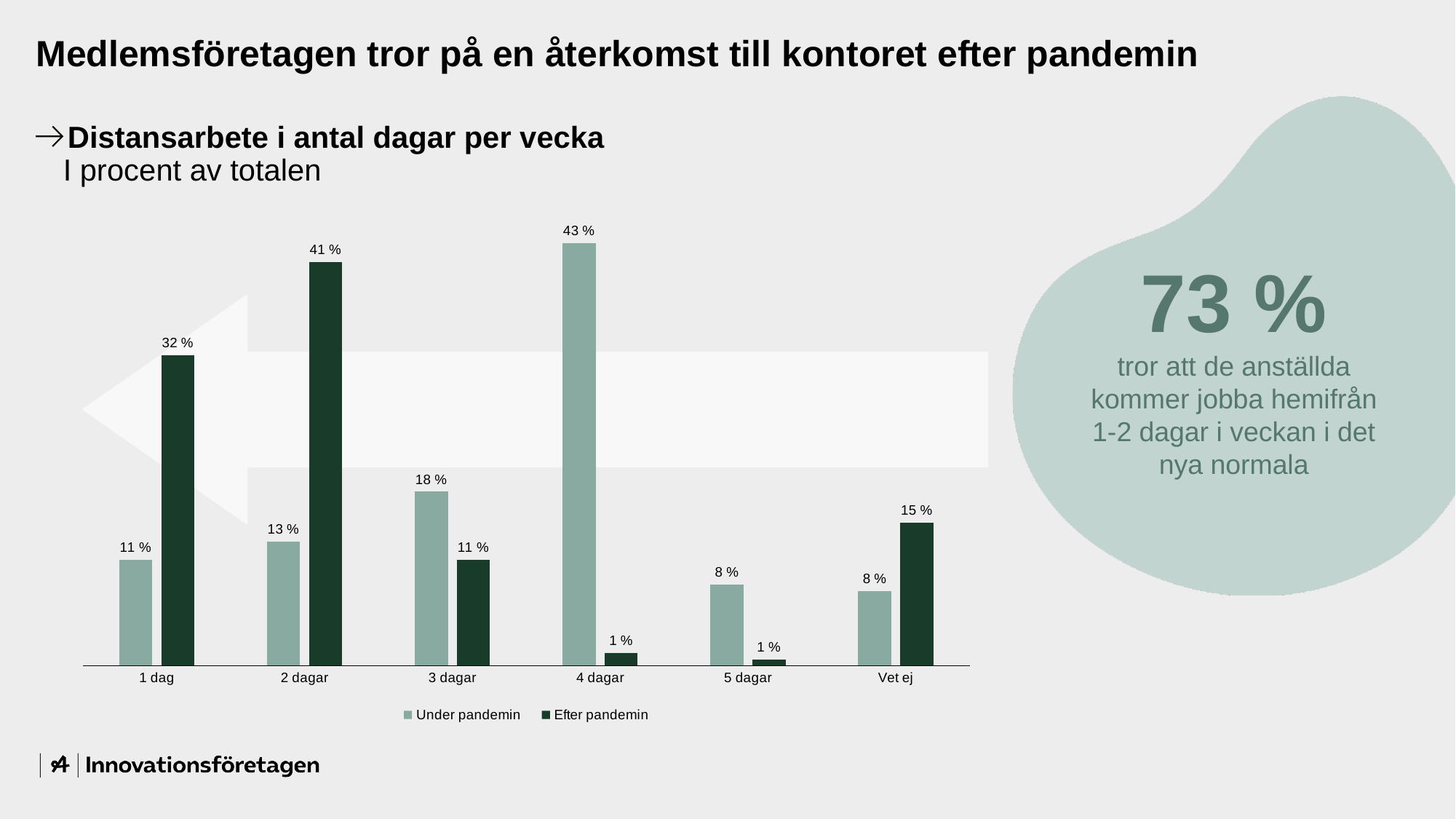
What is the difference between the "Efter pandemin" and "Under pandemin" values for "1 dag"? 21 % Which category has the lowest value in the "Under pandemin" series? 5 dagar and Vet ej (both 8 %) What is the value for "Vet ej" in the "Efter pandemin" series? 15 % How many categories are shown on the x axis of the chart? 6 How many series does the chart legend list? 2 What is the value for "5 dagar" in the "Efter pandemin" series? 1 % What is the value for "2 dagar" in the "Efter pandemin" series? 41 % What is the value for "4 dagar" in the "Under pandemin" series? 43 % What kind of chart is shown on the slide? Bar chart For "3 dagar", which series has the larger value, "Under pandemin" or "Efter pandemin"? Under pandemin Which category has the highest value in the "Efter pandemin" series? 2 dagar What are the two series named in the chart legend? Under pandemin, Efter pandemin